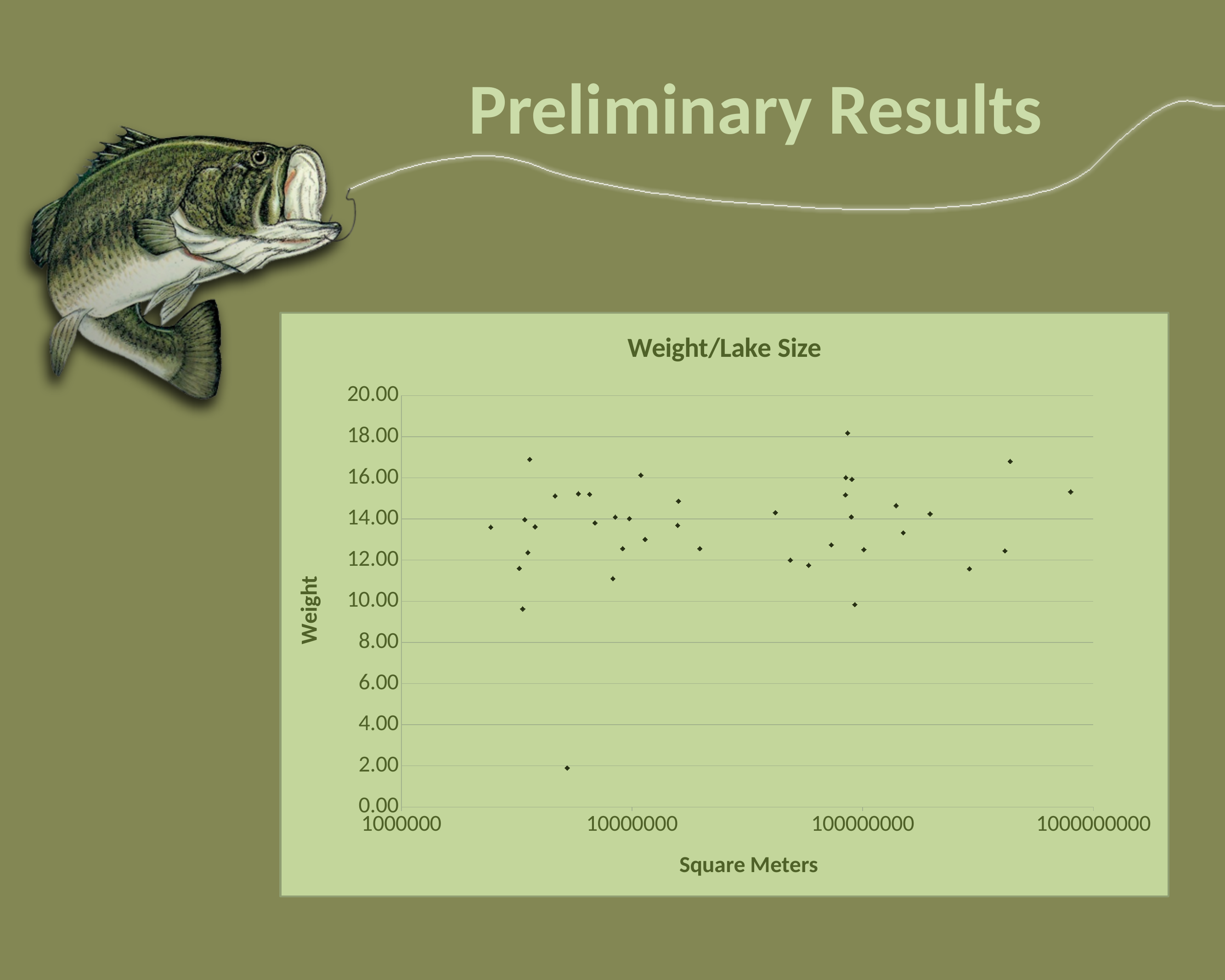
Is the weight of the lowest point on the chart greater or less than 4.00? less What is the title of the chart? Weight/Lake Size What kind of chart is shown on the slide? scatter chart Is the weight of the rightmost point on the chart greater or less than 14.00? greater Is the weight of the highest point on the chart greater or less than 16.00? greater What is the label of the x axis of the chart? Square Meters